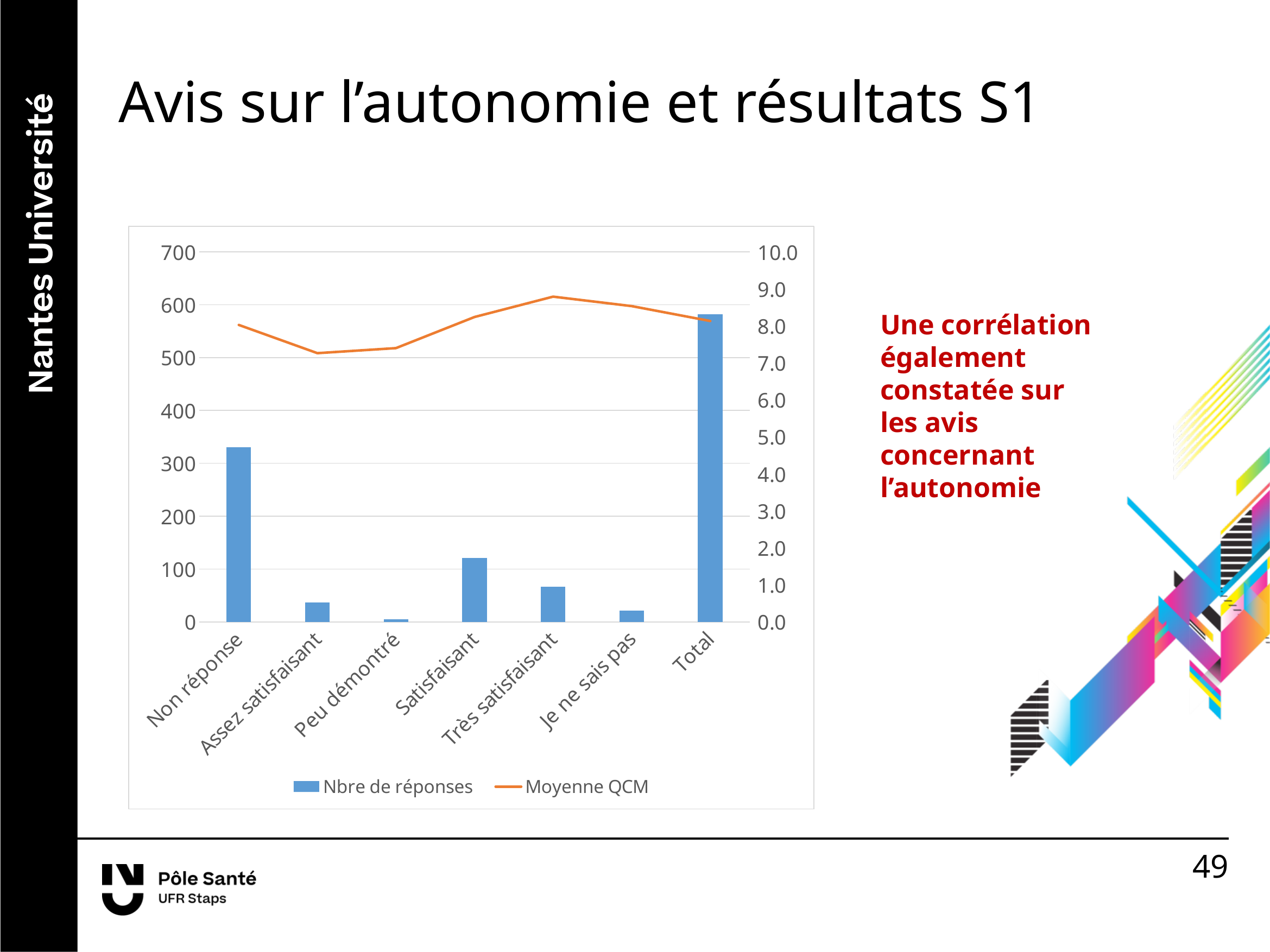
How many series does the legend list? 2 Which category has the highest number of responses (Nbre de réponses)? Total Which has more responses, Satisfaisant or Très satisfaisant? Satisfaisant Which category has the lowest number of responses (Nbre de réponses)? Peu démontré What kind of chart is shown on the slide? A bar chart combined with a line chart How many categories are shown on the x axis? 7 Is the number of responses for Je ne sais pas greater or less than 100? less Which category has the highest Moyenne QCM? Très satisfaisant What colour is the Moyenne QCM line? Orange Is the number of responses for Non réponse greater or less than 300? greater Excluding Total, which category has the highest number of responses (Nbre de réponses)? Non réponse Is the number of responses for Satisfaisant greater or less than 100? greater